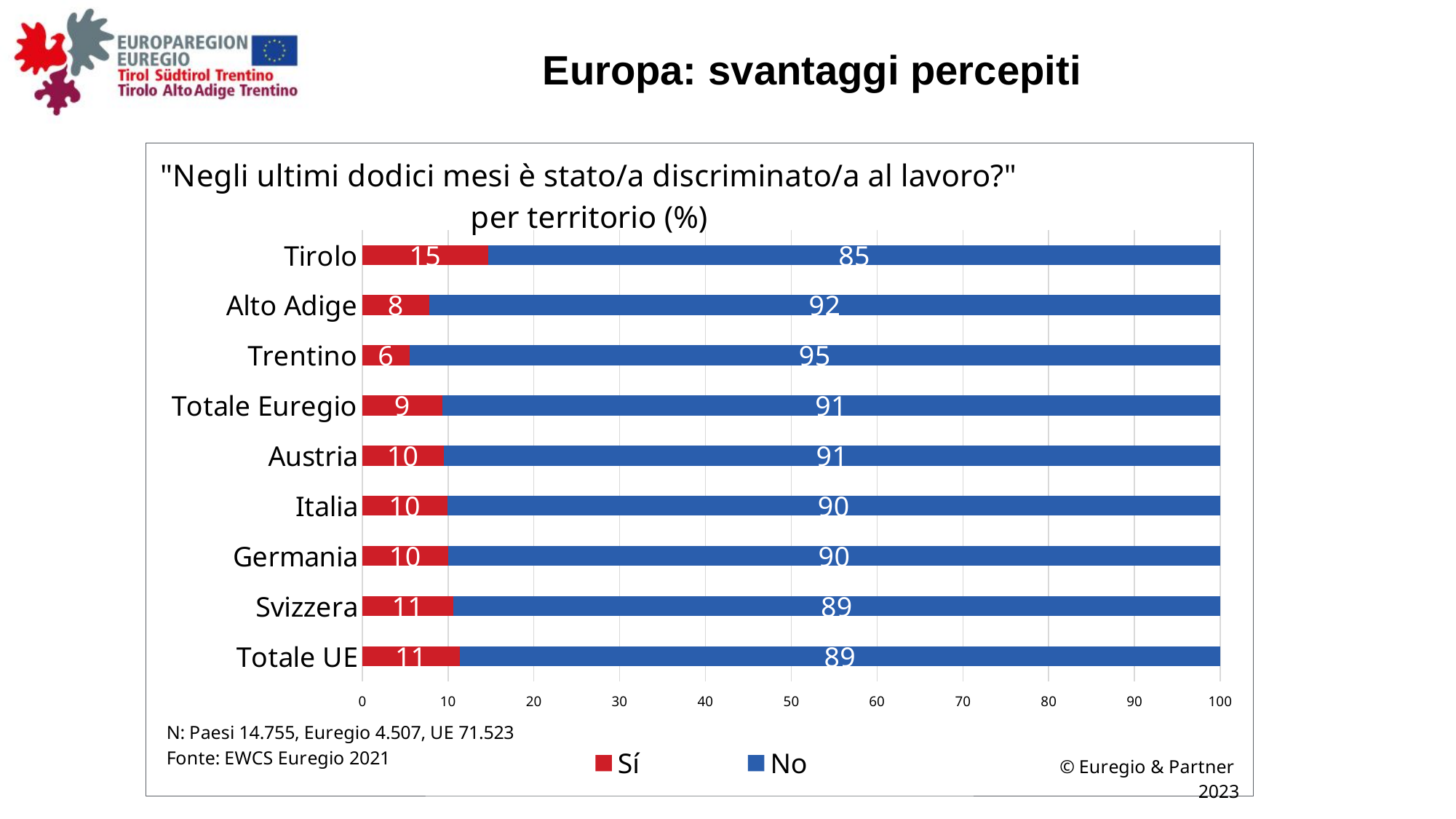
Which has a larger 'No' value, Alto Adige or Svizzera? Alto Adige What is the 'No' value for Trentino? 95 What is the 'Sí' value for Tirolo? 15 What kind of chart is shown on the slide? Stacked bar chart What is the total of the stacked bar for Austria? 101 What is the difference between the 'Sí' values for Tirolo and Alto Adige? 7 Which territory has the highest 'Sí' value? Tirolo How many series does the legend list? 2 What is the 'Sí' value for Totale UE? 11 How many territories are shown on the chart? 9 Which colour represents the 'No' series in the chart? Blue Which territory has the lowest 'Sí' value? Trentino